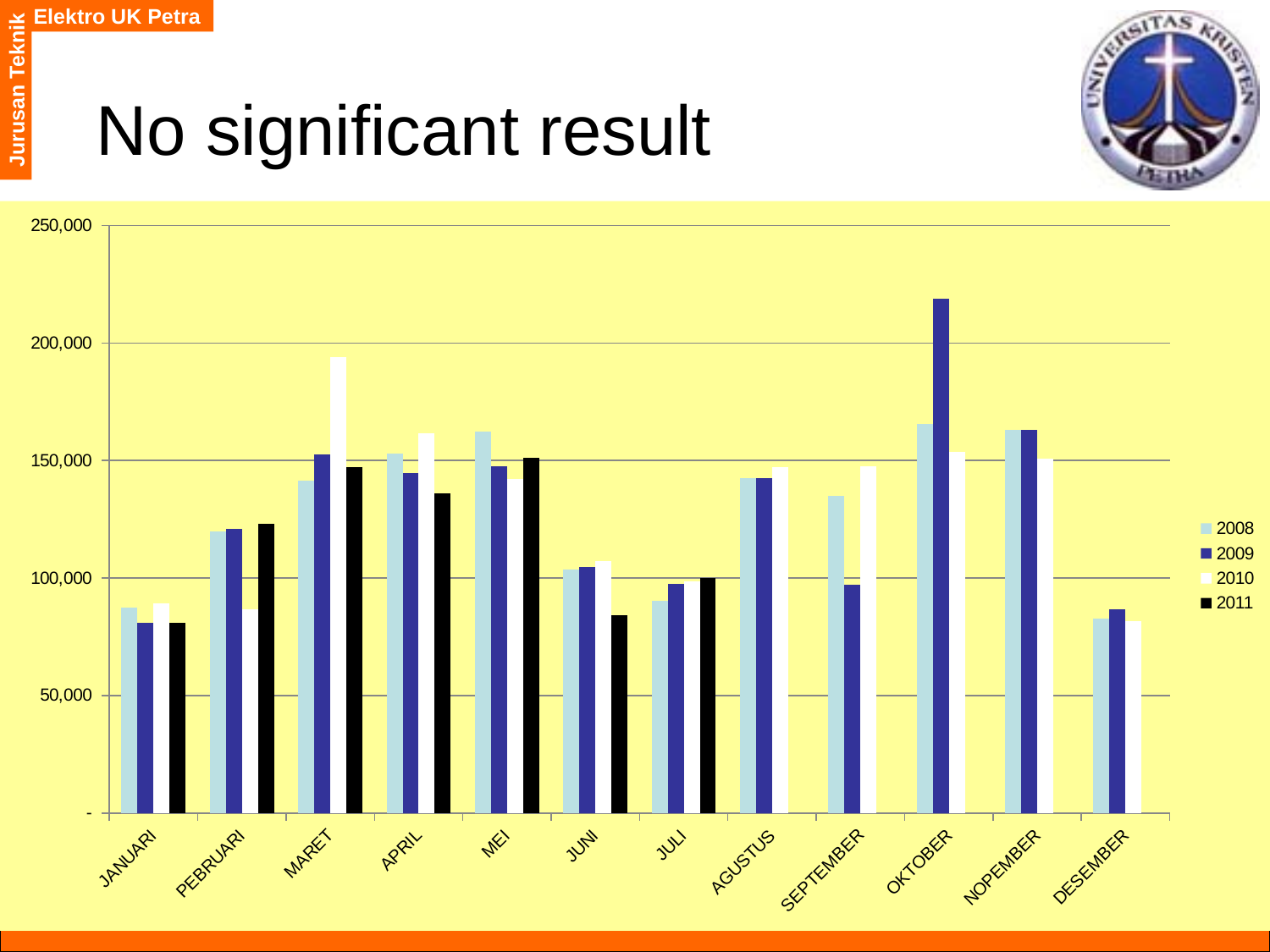
How many series does the chart legend list? 4 Is the 2011 value for JUNI greater or less than 100,000? less What kind of chart is shown on the slide? bar chart Which month has the highest value for the 2010 series? MARET What is the title of the slide containing the chart? No significant result Is the 2009 value for OKTOBER greater or less than 200,000? greater For how many months does the chart show a 2011 bar? 7 Which month and year has the tallest bar in the chart? OKTOBER 2009 How many months (categories) are shown on the x axis of the chart? 12 For OKTOBER, which is larger: the 2009 value or the 2010 value? 2009 Is the 2011 value for PEBRUARI greater or less than 100,000? greater Which years are listed in the chart legend? 2008, 2009, 2010, 2011